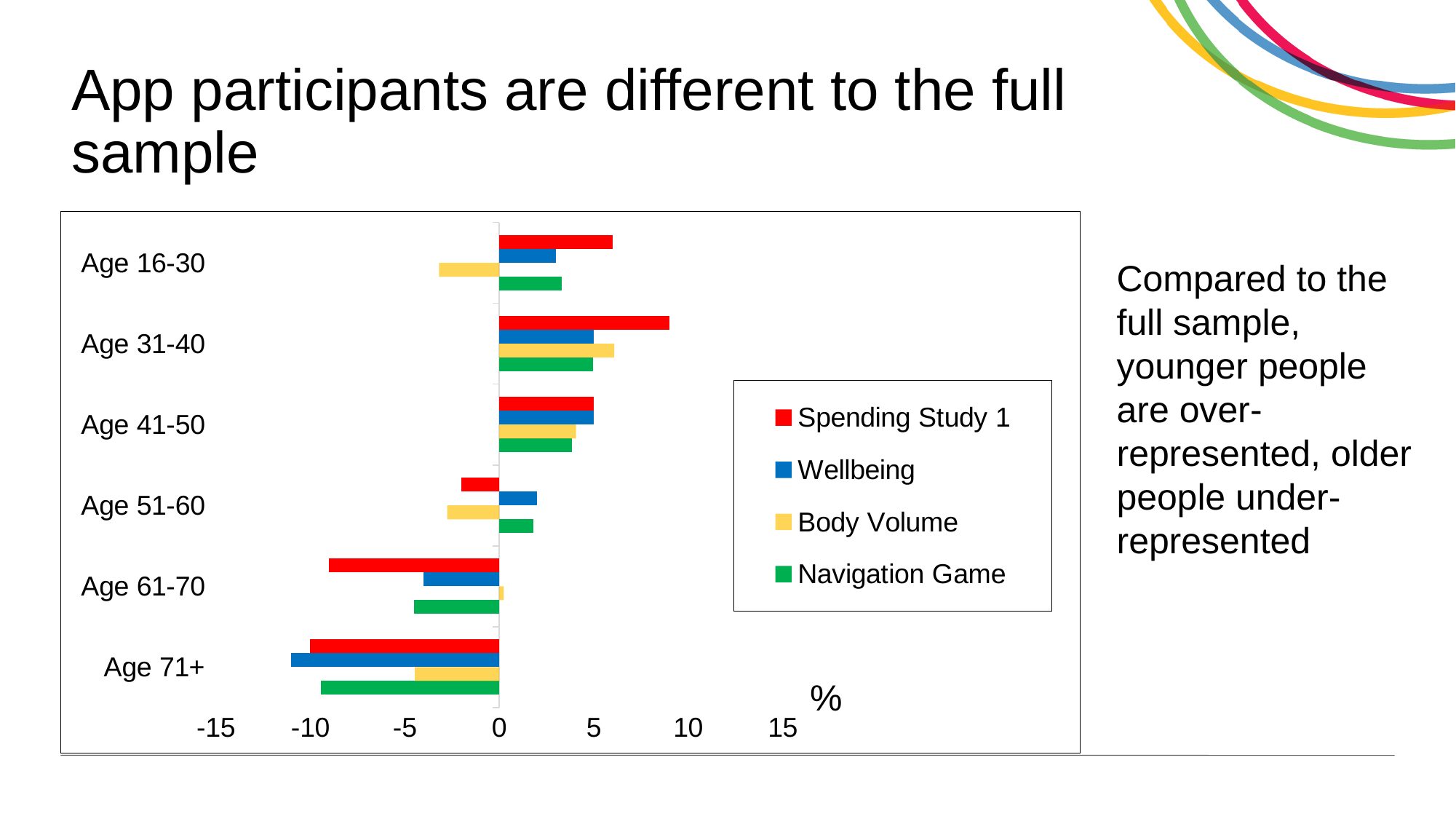
Which age group has the highest value for Spending Study 1? Age 31-40 Is the Body Volume value for Age 16-30 greater or less than 0? less Do the Navigation Game values generally rise or fall moving from Age 31-40 to Age 71+? fall Which age group has the lowest value for Wellbeing? Age 71+ What kind of chart is shown on the slide? bar chart Is the Spending Study 1 value for Age 61-70 greater or less than -5? less Which is larger, the Spending Study 1 value for Age 16-30 or for Age 31-40? Age 31-40 How many series does the legend list? 4 Is the Spending Study 1 value for Age 31-40 greater or less than 5? greater What colour represents the Wellbeing series in the legend? blue How many age groups are shown on the chart? 6